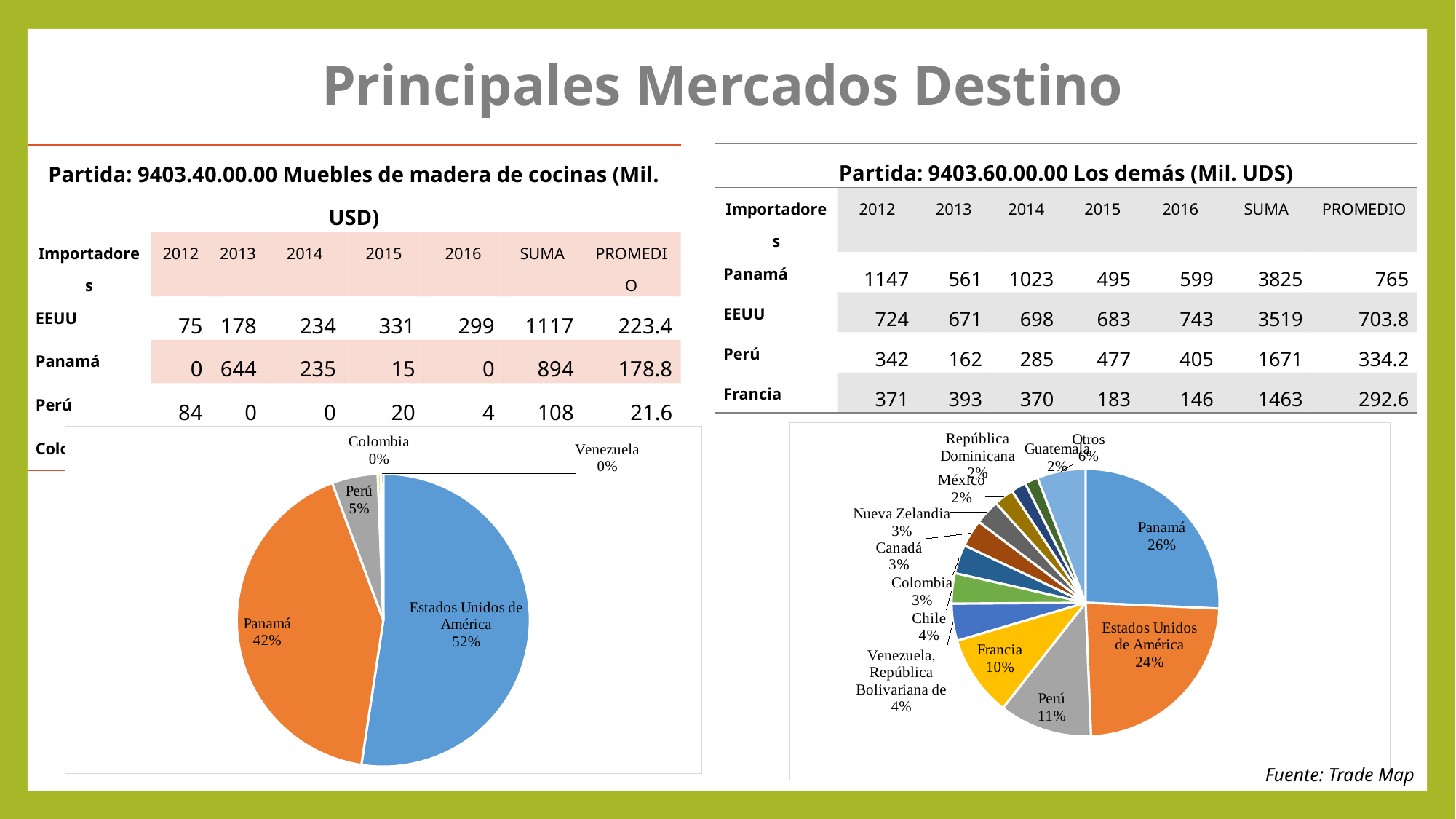
In the pie chart on the right of the slide, how many slices are labelled? 13 In the pie chart on the right of the slide, what share does Francia have? 10% In the pie chart on the left of the slide, how many slices are labelled? 5 What kind of chart is shown on the left of the slide? Pie chart In the pie chart on the right of the slide, which is larger, the slice for Perú or the slice for Francia? Perú In the pie chart on the right of the slide, what is the difference in percentage points between Panamá and Estados Unidos de América? 2 In the pie chart on the left of the slide, which category has the largest slice? Estados Unidos de América In the pie chart on the left of the slide, what share does Estados Unidos de América have? 52% In the pie chart on the right of the slide, what share does Panamá have? 26% In the pie chart on the right of the slide, which category has the largest slice? Panamá In the pie chart on the left of the slide, what is the difference in percentage points between Estados Unidos de América and Panamá? 10